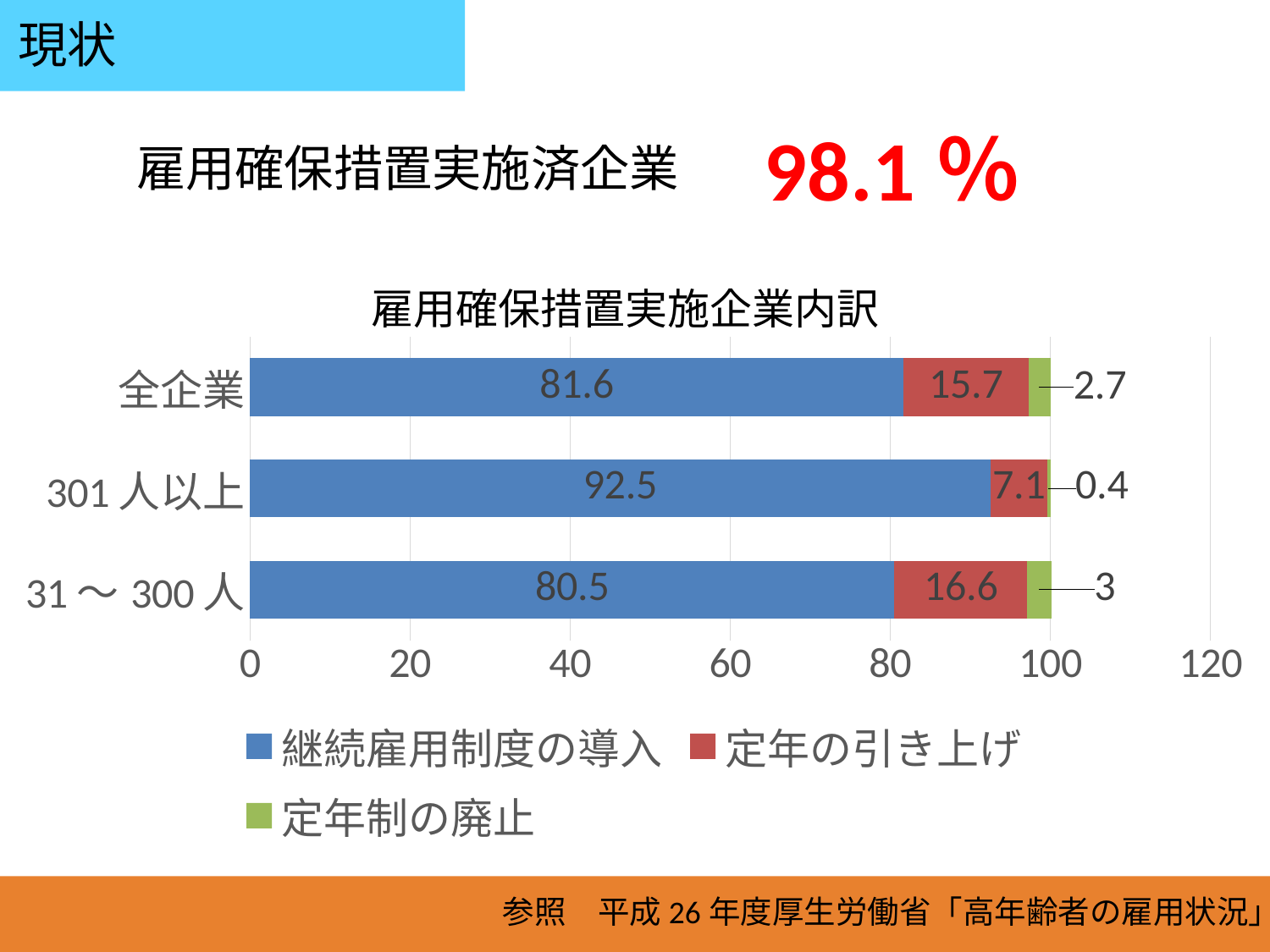
What is the value of 継続雇用制度の導入 for 全企業? 81.6 How many series does the legend list? 3 How many categories are shown on the chart? 3 What is the difference between the 継続雇用制度の導入 values for 301人以上 and 31～300人? 12 What is the total of the stacked bar for 全企業? 100 Which is larger: 定年の引き上げ for 全企業 or for 31～300人? 31～300人 Which category has the highest value for 継続雇用制度の導入? 301人以上 What is the value of 定年の引き上げ for 301人以上? 7.1 What is the value of 定年制の廃止 for 31～300人? 3 What type of chart is shown on the slide? Stacked bar chart What is the title of the chart? 雇用確保措置実施企業内訳 Which category has the lowest value for 定年制の廃止? 301人以上